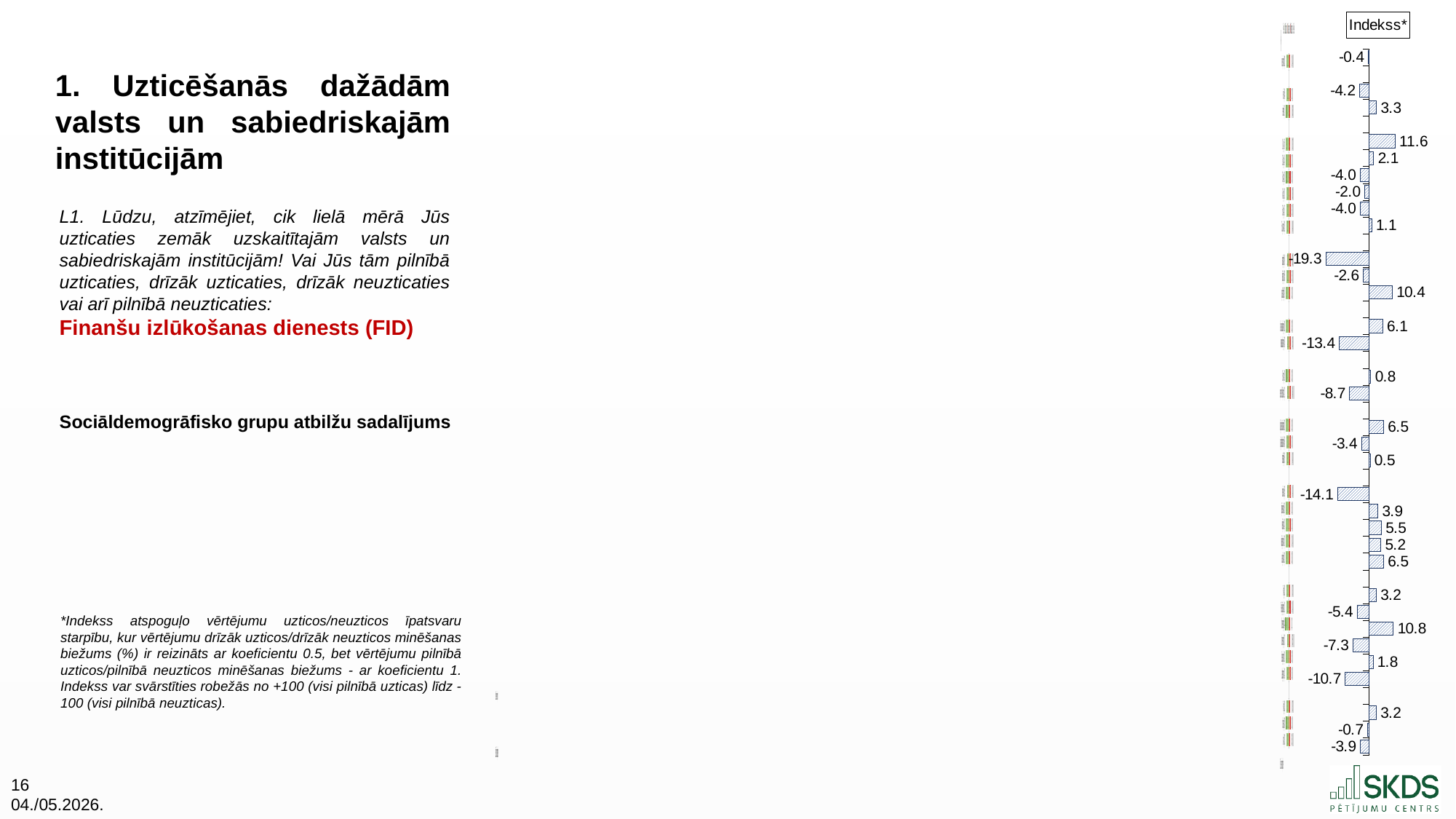
What is the largest value labelled on the Indekss* chart? 11.6 What is the lowest value labelled on the Indekss* chart? -19.3 What kind of chart is shown under the heading "Indekss*"? bar chart Are the bars on the Indekss* chart drawn horizontally or vertically? horizontally What is the title shown above the chart on the right of the slide? Indekss* On the Indekss* chart, which is larger: the value 10.4 or the value 10.8? 10.8 On the Indekss* chart, what is the difference between the largest labelled value (11.6) and the lowest labelled value (-19.3)? 30.9